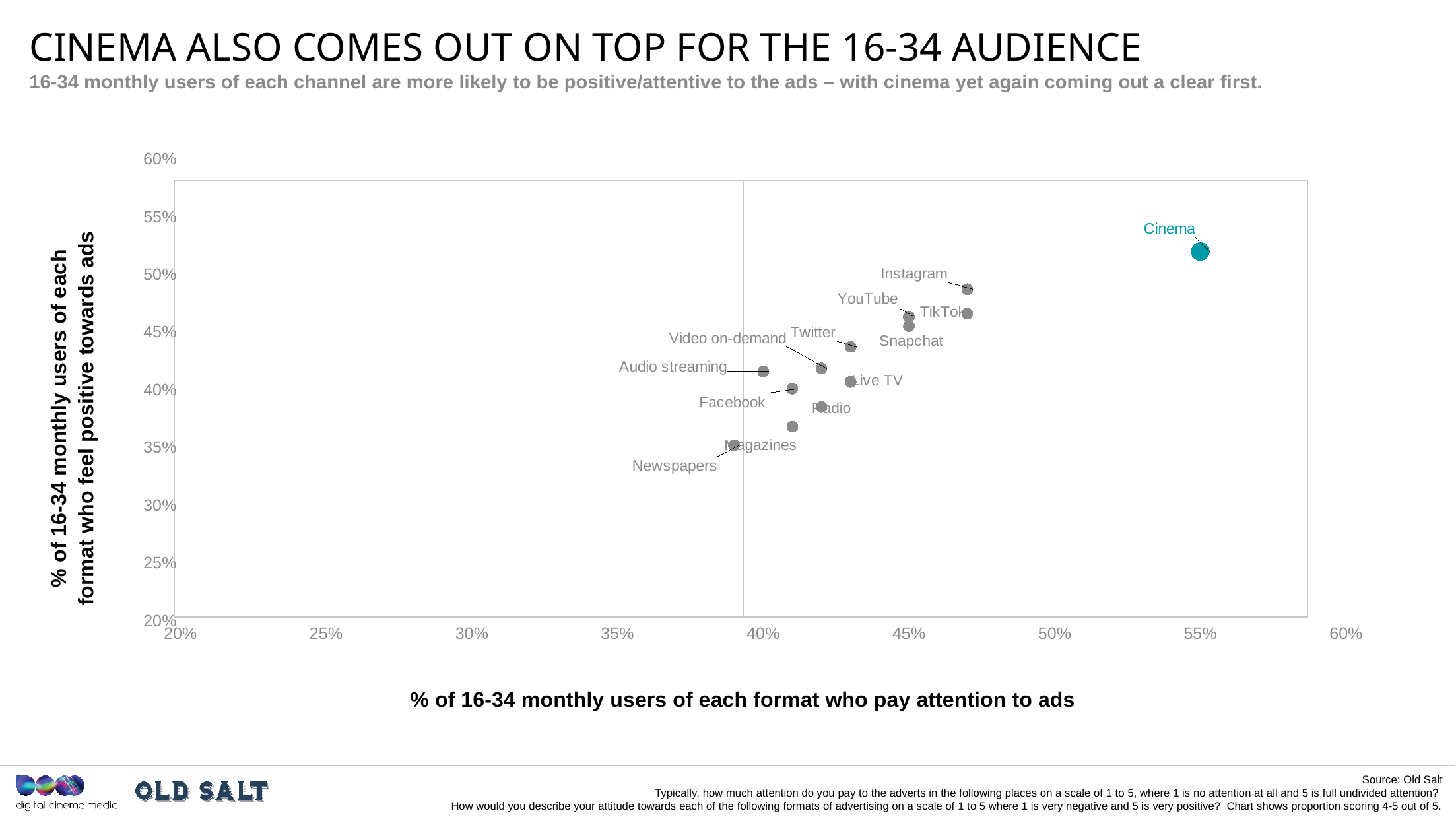
Which format has the lowest percentage of 16-34 monthly users who pay attention to ads? Newspapers Which format's point is highlighted in a different colour from the others? Cinema Which format has the lowest percentage of 16-34 monthly users who feel positive towards ads? Newspapers What kind of chart is shown on the slide? Scatter chart Is the percentage of 16-34 monthly users who pay attention to ads for Newspapers greater or less than 40%? less Is the percentage of 16-34 monthly users who feel positive towards ads for Cinema greater or less than 50%? greater Which format has the highest percentage of 16-34 monthly users who pay attention to ads? Cinema Which has a higher percentage of 16-34 monthly users who feel positive towards ads, Instagram or Facebook? Instagram What is the label of the x axis? % of 16-34 monthly users of each format who pay attention to ads Which format has the highest percentage of 16-34 monthly users who feel positive towards ads? Cinema Is the percentage of 16-34 monthly users who feel positive towards ads for Magazines greater or less than 40%? less How many formats are plotted on the chart? 13